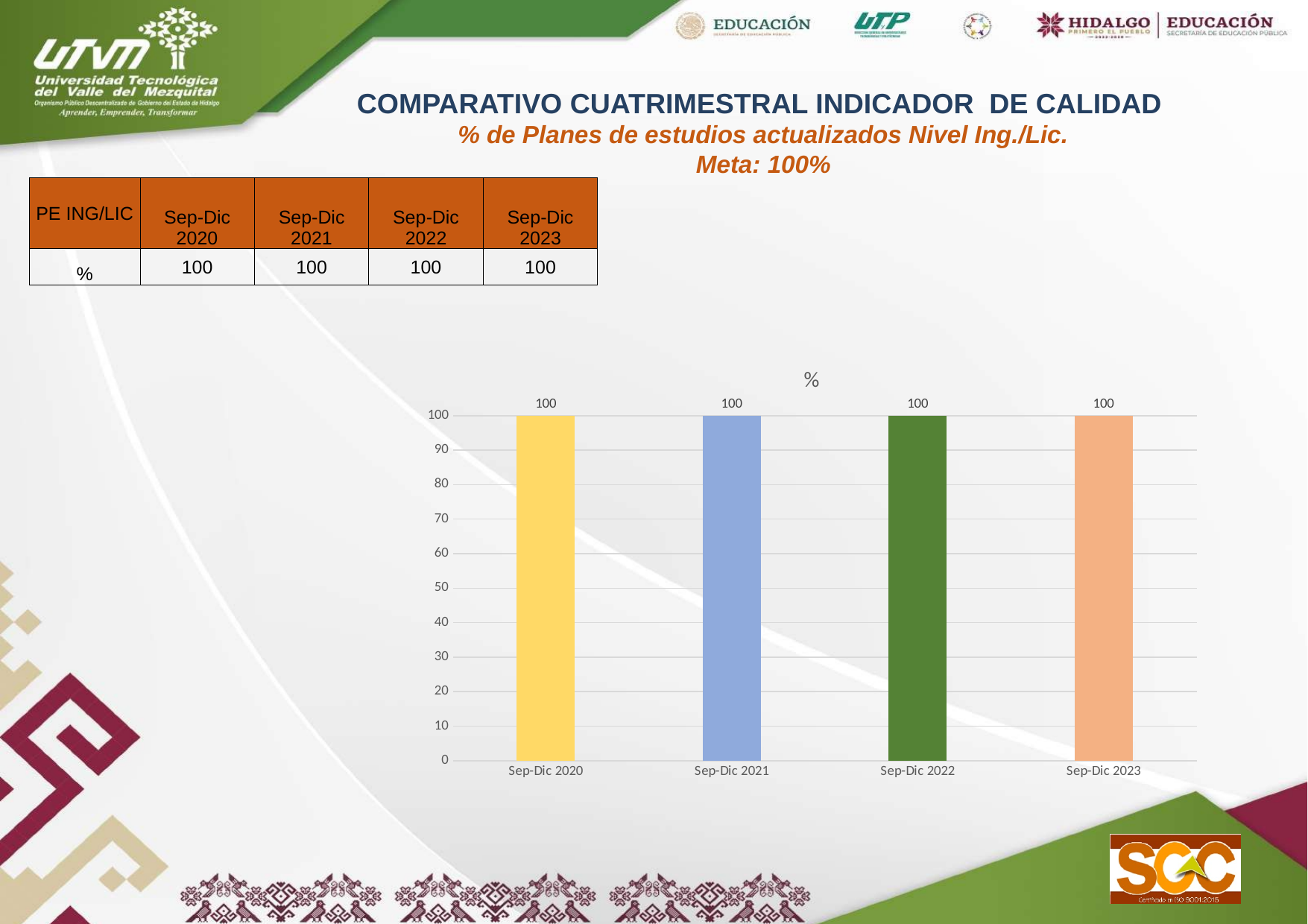
Do the values rise, fall, or stay the same from Sep-Dic 2020 to Sep-Dic 2023? stay the same What is the value for Sep-Dic 2021 in the chart? 100 What is the difference between the values for Sep-Dic 2023 and Sep-Dic 2020? 0 What kind of chart is shown on the slide? bar chart What is the value for Sep-Dic 2022 in the chart? 100 What is the value for Sep-Dic 2020 in the chart? 100 How many categories are shown on the x axis of the chart? 4 What colour is the bar for Sep-Dic 2022? green What is the title of the chart? % Is the value for Sep-Dic 2022 greater or less than 50? greater What is the value for Sep-Dic 2023 in the chart? 100